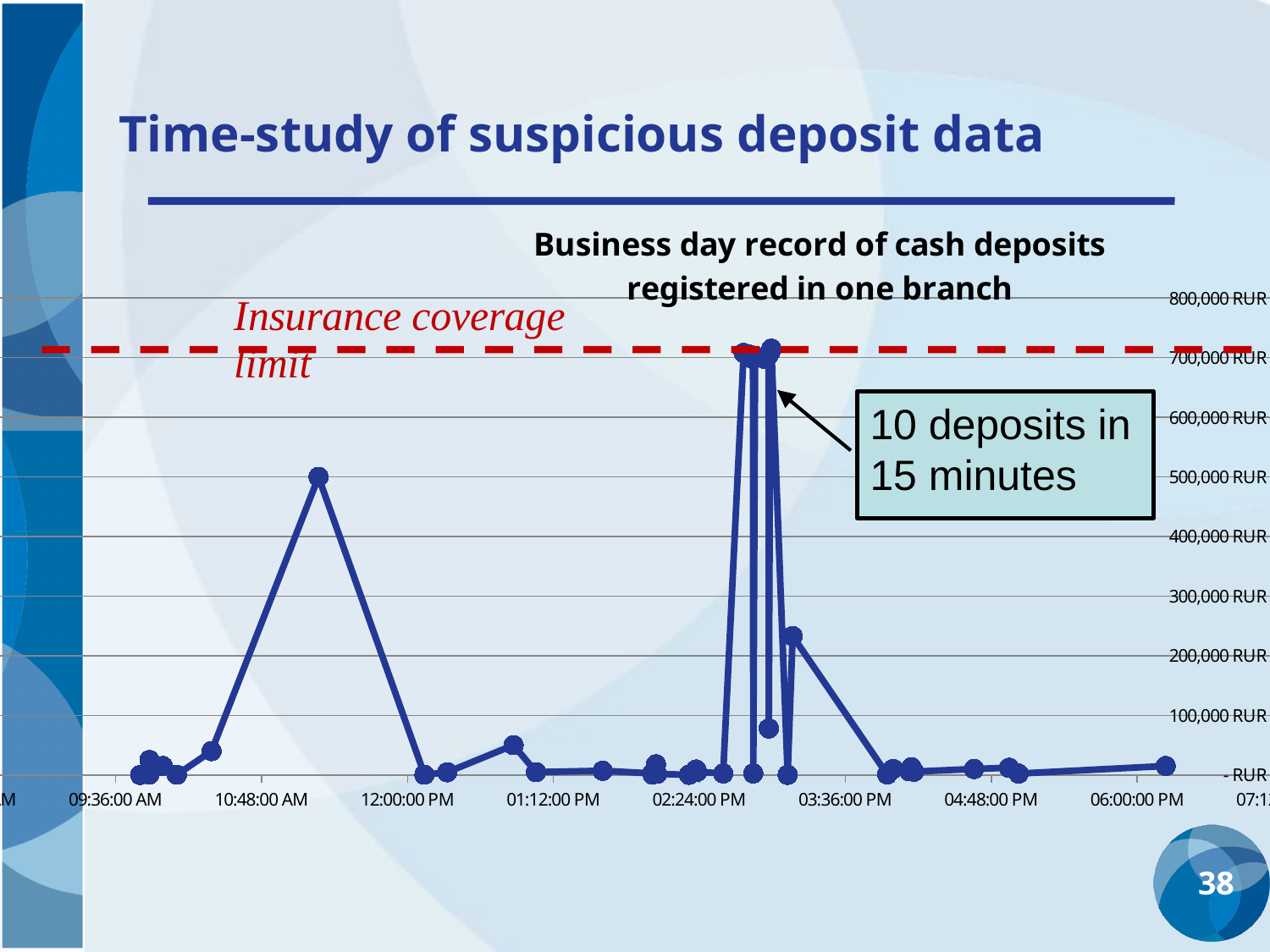
Is the value of the peak between 10:48:00 AM and 12:00:00 PM greater or less than 600,000 RUR? less What is the highest value shown on the vertical axis? 800,000 RUR Is the value of the peak between 10:48:00 AM and 12:00:00 PM greater or less than 400,000 RUR? greater Which is higher: the peak between 10:48:00 AM and 12:00:00 PM or the spike shortly after 02:24:00 PM? the spike shortly after 02:24:00 PM Is the value at 06:00:00 PM greater or less than 100,000 RUR? less What does the red dashed horizontal line on the chart represent? Insurance coverage limit What is the title of the chart? Business day record of cash deposits registered in one branch What kind of chart is shown on the slide? line chart